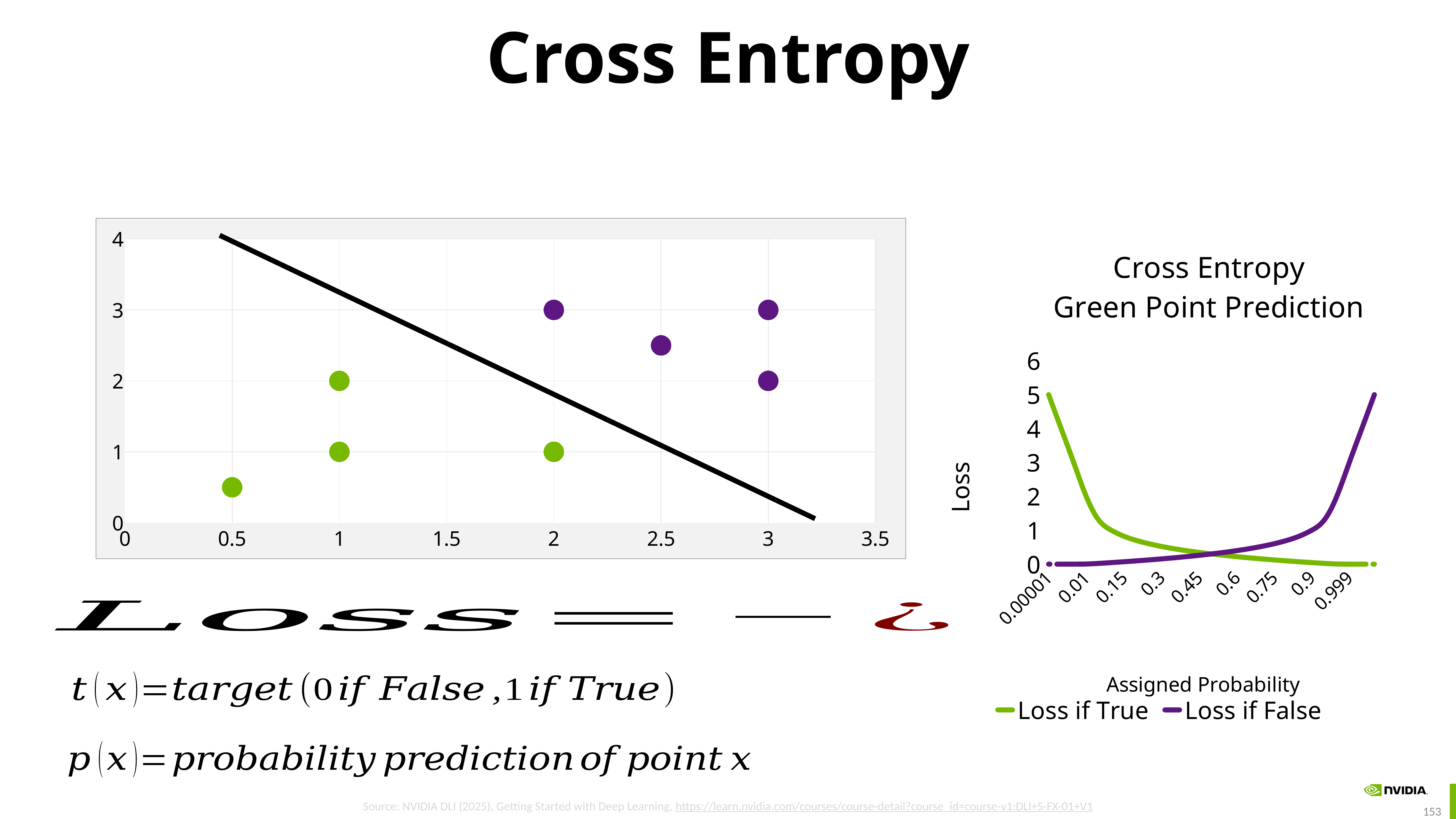
In the 'Cross Entropy Green Point Prediction' chart, how many assigned probability values are labelled on the x axis? 9 What kind of chart is the 'Cross Entropy Green Point Prediction' chart? line chart In the 'Cross Entropy Green Point Prediction' chart, how many series does the legend list? 2 In the chart on the left, how many green points are plotted? 4 In the 'Cross Entropy Green Point Prediction' chart, which series has the larger loss at an assigned probability of 0.01? Loss if True In the 'Cross Entropy Green Point Prediction' chart, does the 'Loss if True' line rise or fall as assigned probability increases? fall What kind of chart is the chart on the left of the slide? scatter chart In the chart on the left, how many purple points are plotted? 4 In the chart on the left, what is the y value of the green point at x = 2? 1 In the 'Cross Entropy Green Point Prediction' chart, what is the label of the y axis? Loss